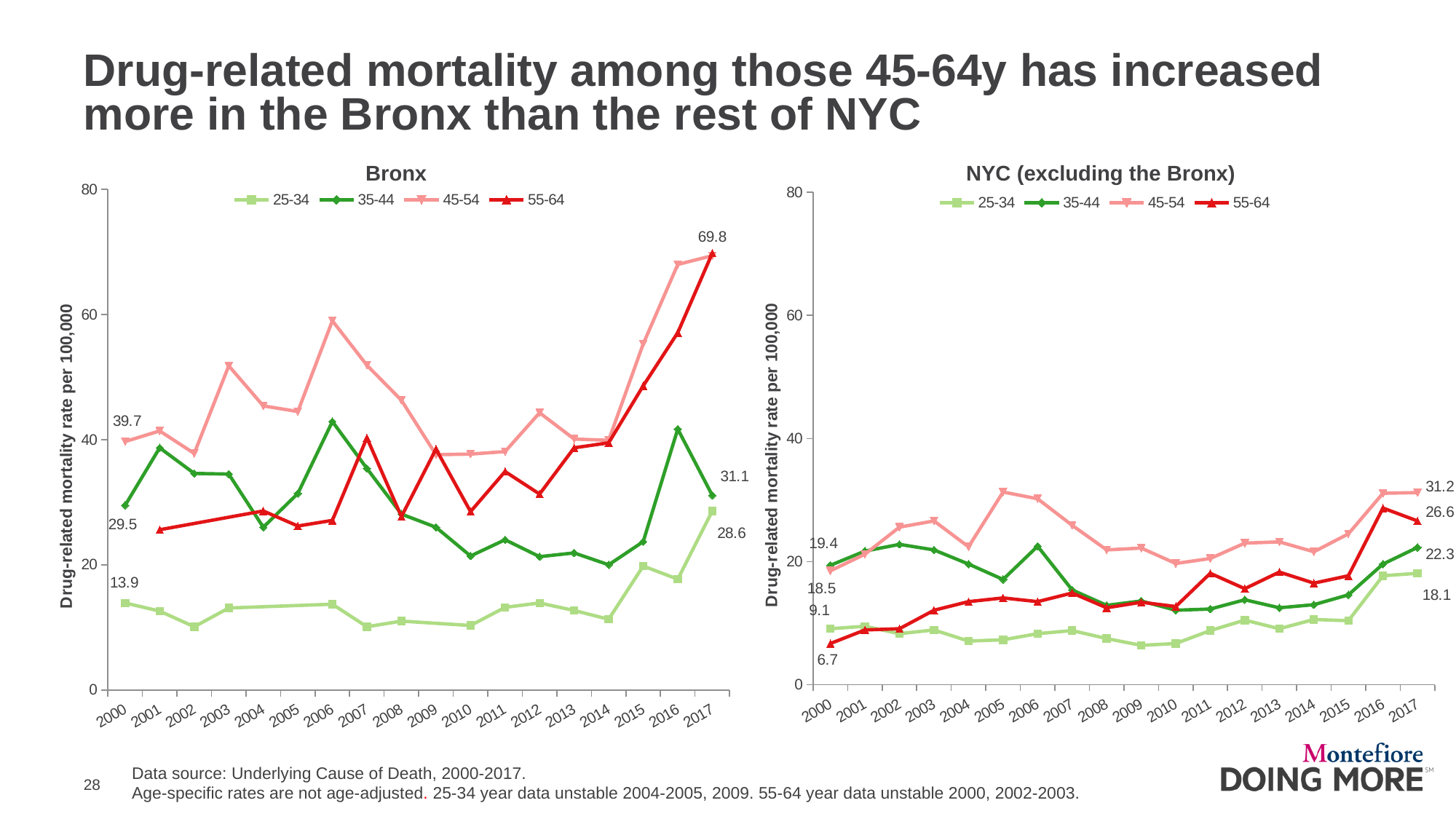
How many series does the legend of the NYC (excluding the Bronx) chart list? 4 In the NYC (excluding the Bronx) chart, what is the difference between the 55-64 value in 2017 (26.6) and in 2000 (6.7)? 19.9 In the Bronx chart, what is the value for the 35-44 group in 2017? 31.1 What kind of chart is the Bronx chart? line chart What is the y-axis title of the NYC (excluding the Bronx) chart? Drug-related mortality rate per 100,000 In the NYC (excluding the Bronx) chart, what is the value for the 55-64 group in 2000? 6.7 In the Bronx chart, what is the drug-related mortality rate for the 25-34 group in 2000? 13.9 How many years are plotted along the x axis of the Bronx chart? 18 In the Bronx chart, is the value for the 45-54 group in 2006 greater or less than 40? greater In the NYC (excluding the Bronx) chart, what is the value for the 45-54 group in 2017? 31.2 In the Bronx chart, which group has the larger value in 2017: 35-44 or 25-34? 35-44 In the Bronx chart, by how much did the 25-34 rate increase from 2000 (13.9) to 2017 (28.6)? 14.7